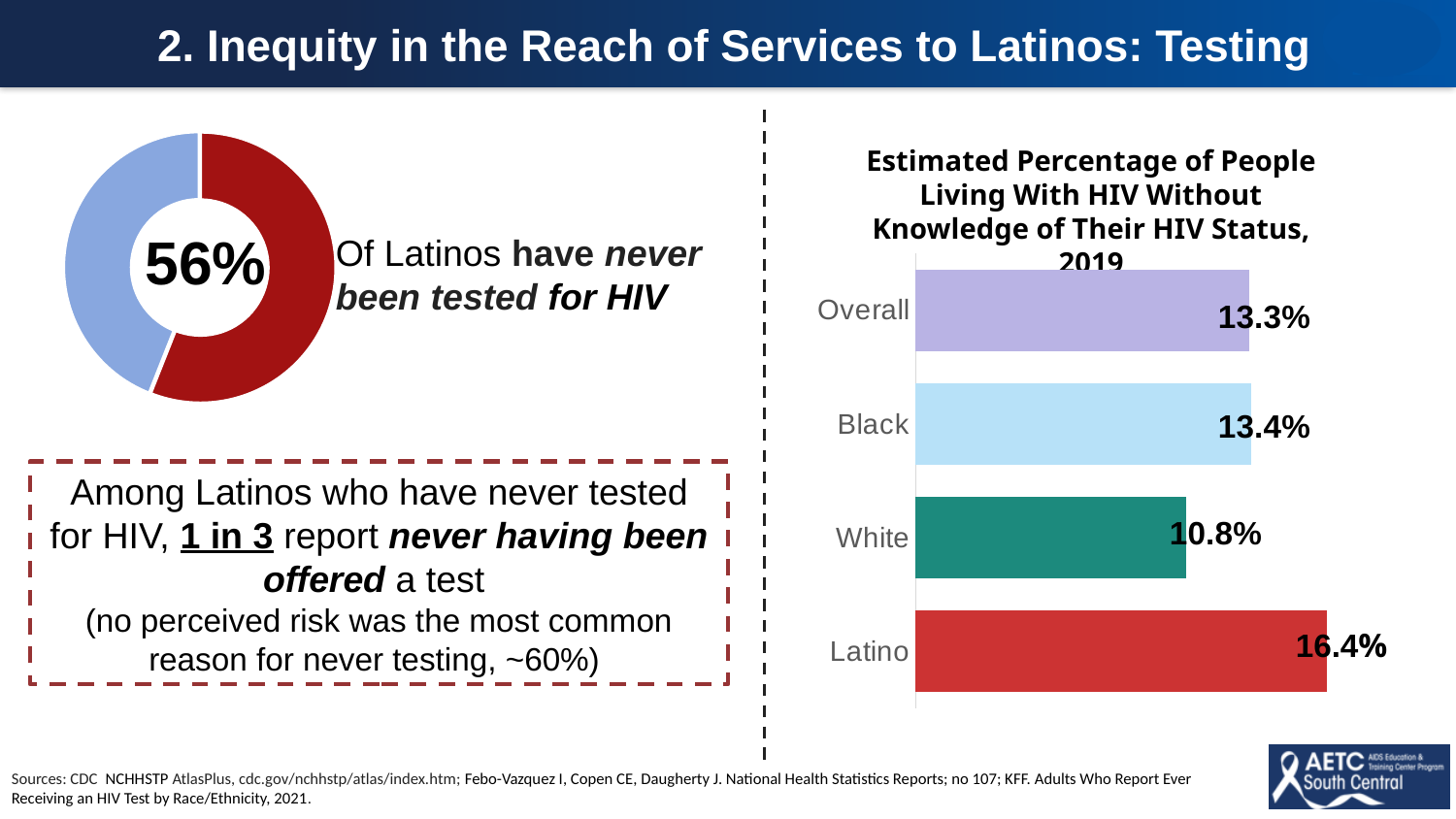
In the bar chart on the right, what is the value for Latino? 16.4% How many categories are shown in the bar chart on the right? 4 What kind of chart is on the right side of the slide? Bar chart In the bar chart on the right, what is the difference between the Latino and White values? 5.6% In the bar chart on the right, what is the value for Overall? 13.3% What is the title of the bar chart on the right? Estimated Percentage of People Living With HIV Without Knowledge of Their HIV Status, 2019 In the donut chart on the left, what percentage of Latinos have never been tested for HIV? 56% In the bar chart on the right, which category has the lowest value? White In the bar chart on the right, which category has the highest value? Latino In the bar chart on the right, what is the value for White? 10.8% In the bar chart on the right, which is larger, the value for Latino or the value for Overall? Latino In the bar chart on the right, what is the value for Black? 13.4%